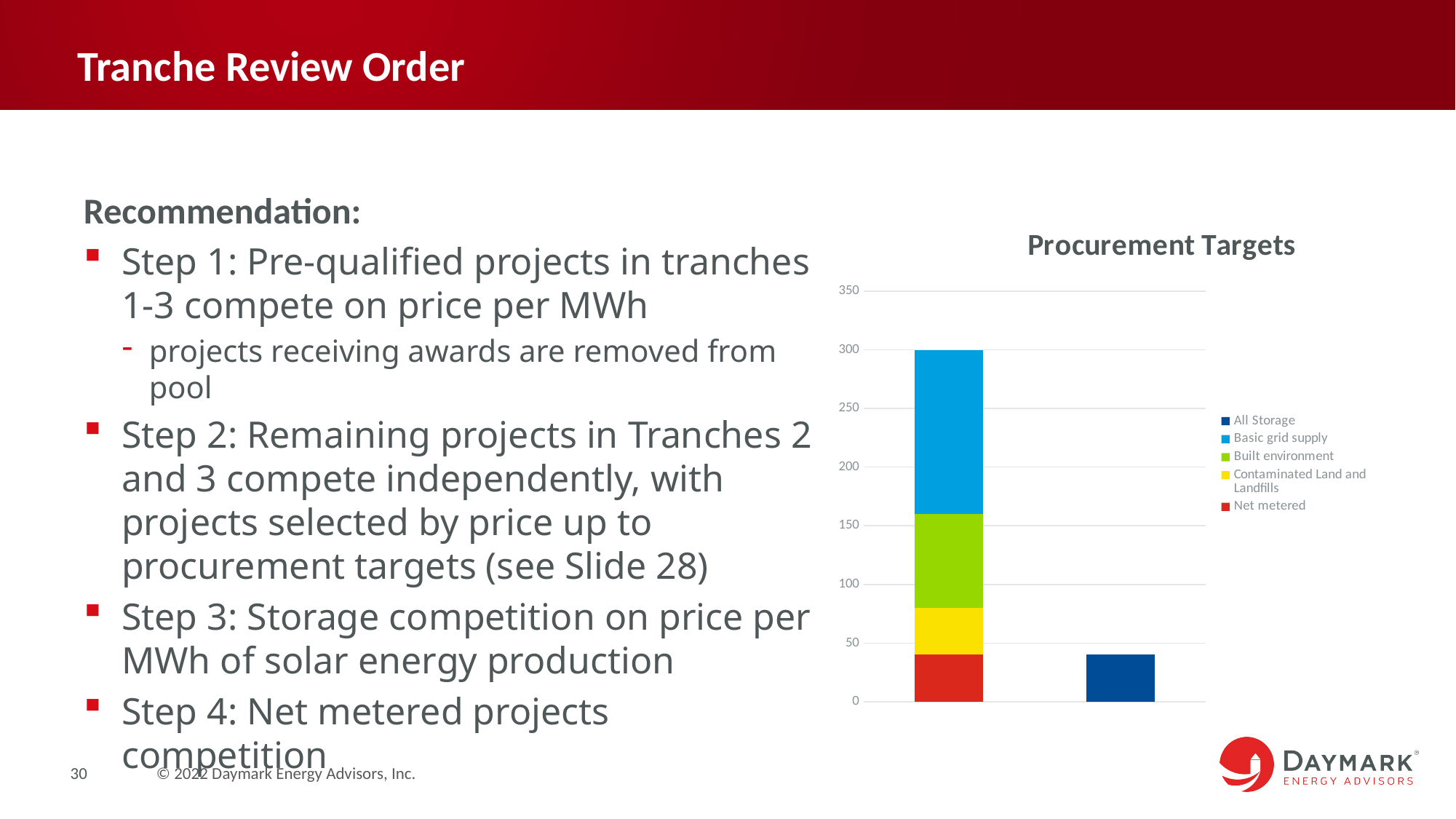
In the Procurement Targets chart, is the value for All Storage greater or less than 50? less In the Procurement Targets chart, is the Built environment segment greater or less than 50? greater What type of chart is shown under the title "Procurement Targets"? Stacked bar chart In the Procurement Targets chart, which segment is larger: Basic grid supply or Built environment? Basic grid supply In the Procurement Targets chart, is the total height of the stacked bar greater or less than 250? greater How many bars are plotted in the Procurement Targets chart? 2 In the Procurement Targets chart, which series has the largest segment in the stacked bar? Basic grid supply What is the title of the chart on the slide? Procurement Targets Which legend entry in the Procurement Targets chart is shown in dark blue? All Storage How many series does the legend of the Procurement Targets chart list? 5